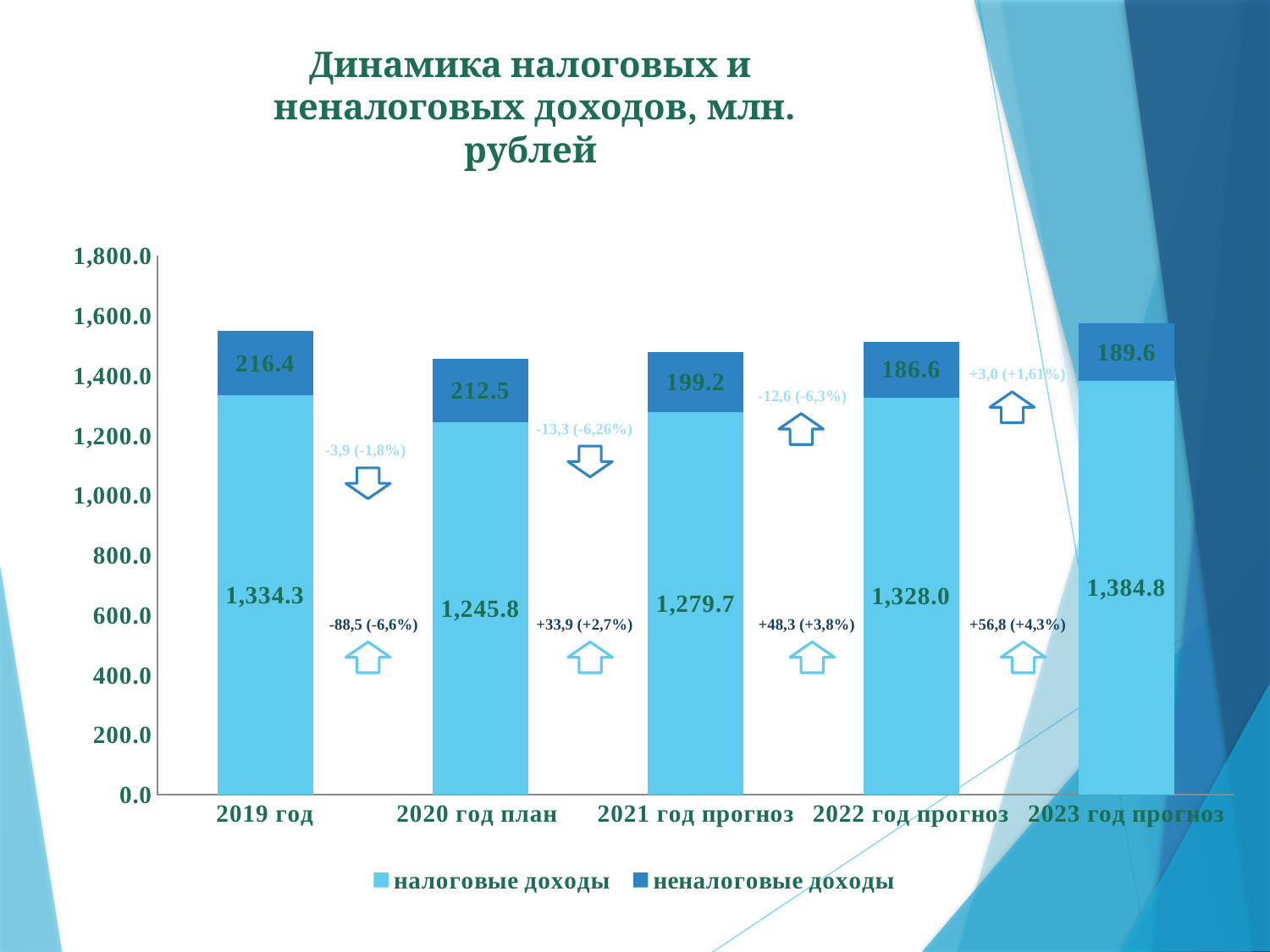
Which is larger: неналоговые доходы in 2019 год or in 2022 год прогноз? 2019 год What is the total of the stacked bar for 2020 год план? 1,458.3 Which category has the highest value of налоговые доходы? 2023 год прогноз What is the value of неналоговые доходы for 2021 год прогноз? 199.2 What kind of chart is shown on the slide? Stacked bar chart What is the value of налоговые доходы for 2022 год прогноз? 1,328.0 How many series does the legend list? 2 How many categories are shown on the x axis? 5 Which category has the lowest value of неналоговые доходы? 2022 год прогноз What is the difference between налоговые доходы in 2023 год прогноз and in 2019 год? 50.5 What is the value of налоговые доходы for 2019 год? 1,334.3 Do the values of налоговые доходы rise or fall from 2020 год план to 2023 год прогноз? Rise